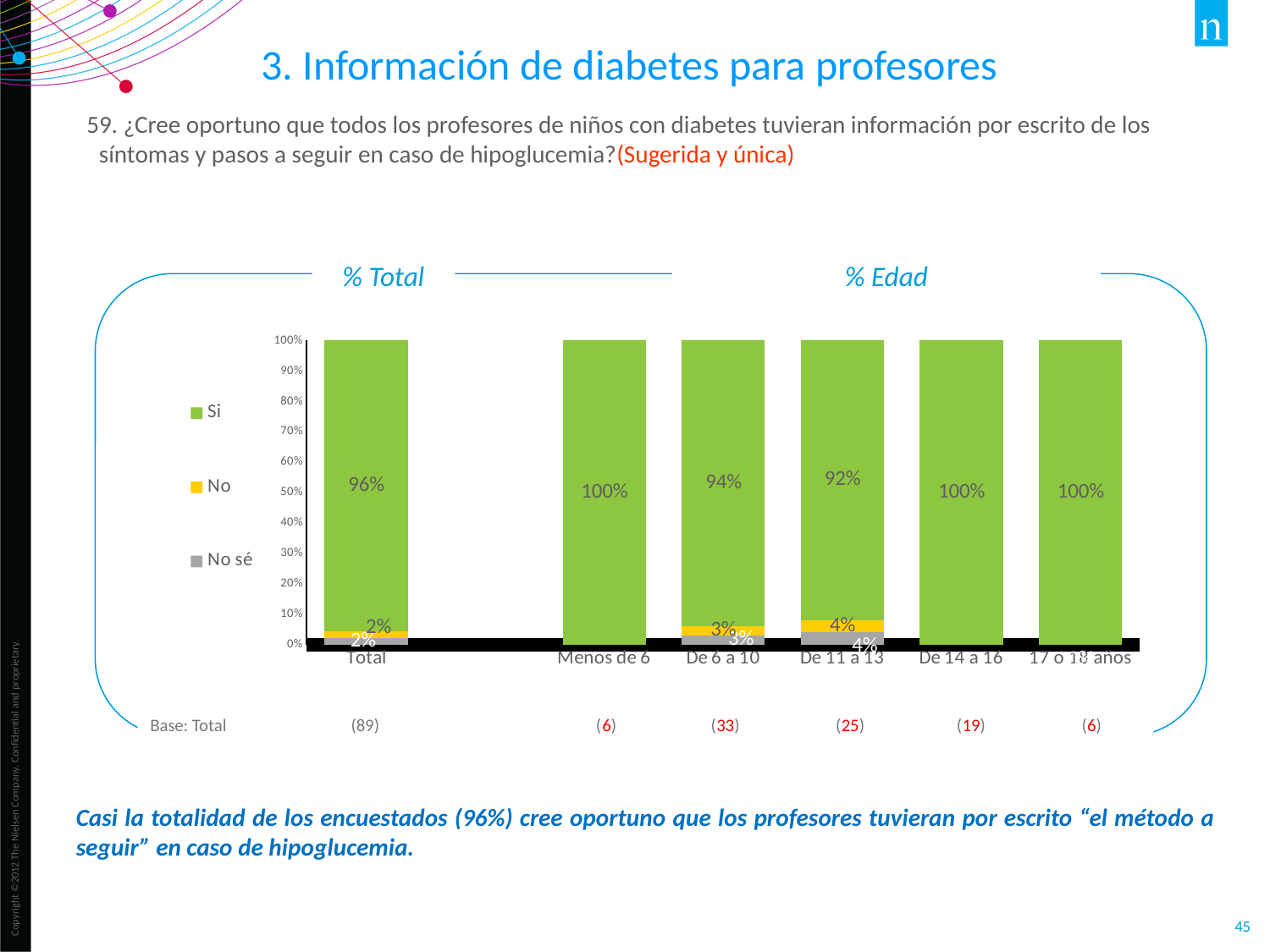
What is the value of "No sé" for the De 6 a 10 category? 3% How many series does the legend list? 3 How many categories are plotted along the x axis? 6 What is the value of "Si" for the Total category? 96% What is the value of "No" for the De 11 a 13 category? 4% Which age category has the lowest value for "Si"? De 11 a 13 What is the value of "Si" for the De 11 a 13 category? 92% Which is larger, the "Si" value for De 6 a 10 or for De 11 a 13? De 6 a 10 What kind of chart is shown on the slide? Stacked bar chart What is the difference between the "Si" value for Total and the "Si" value for De 11 a 13? 4% Which series is shown in green in the legend? Si What is the value of "Si" for the De 6 a 10 category? 94%